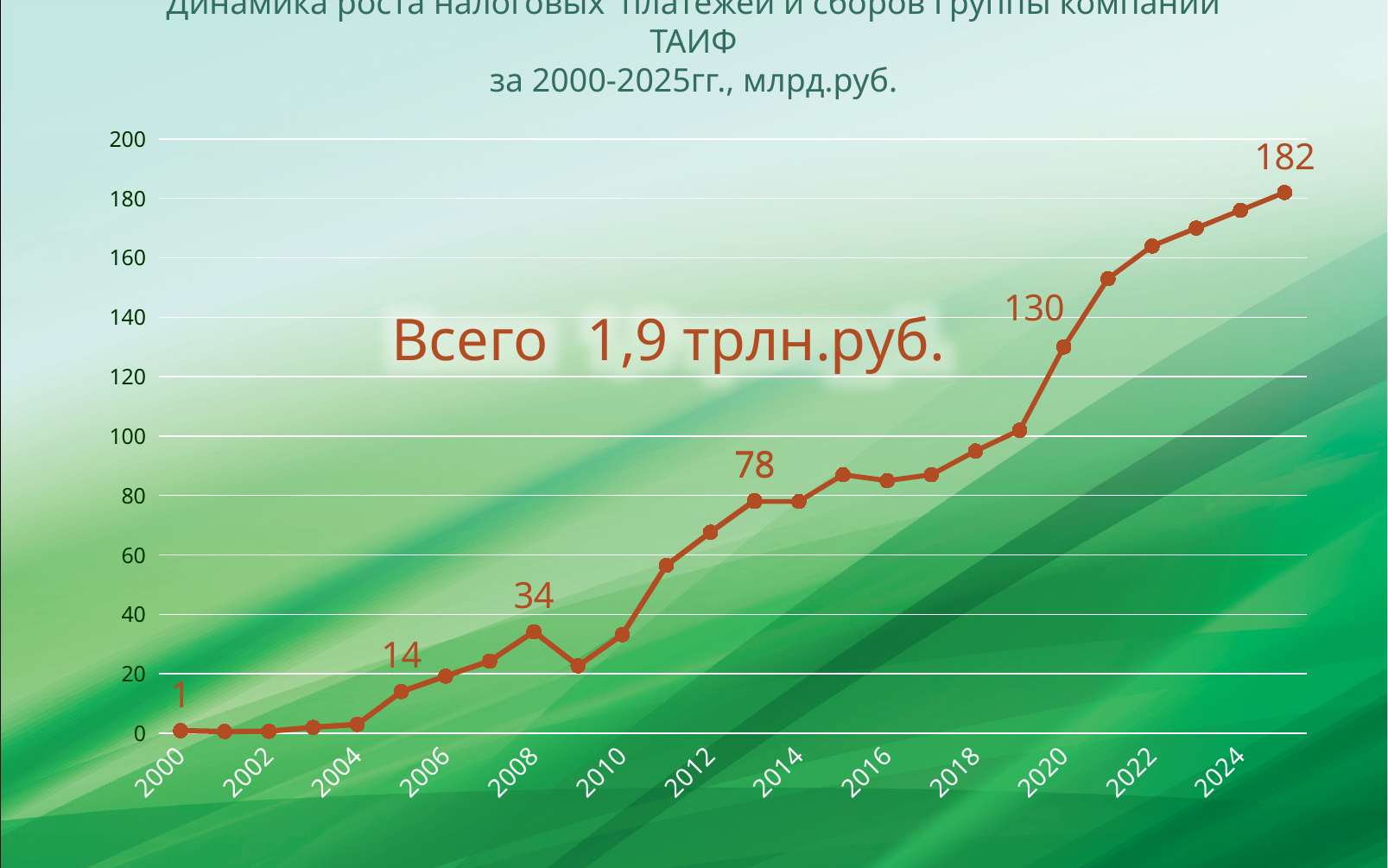
What is the value for 2025? 182 What is the value for 2020? 130 What is the difference between the values for 2025 and 2020? 52 What is the value for 2013? 78 What kind of chart is shown? line chart How many data points are plotted on the line? 26 What is the value for 2005? 14 Which year has the highest value? 2025 Do the values generally rise or fall from 2000 to 2025? rise What is the value for 2008? 34 Which is larger, the value for 2020 or the value for 2013? 2020 Is the value for 2010 greater or less than 40? less